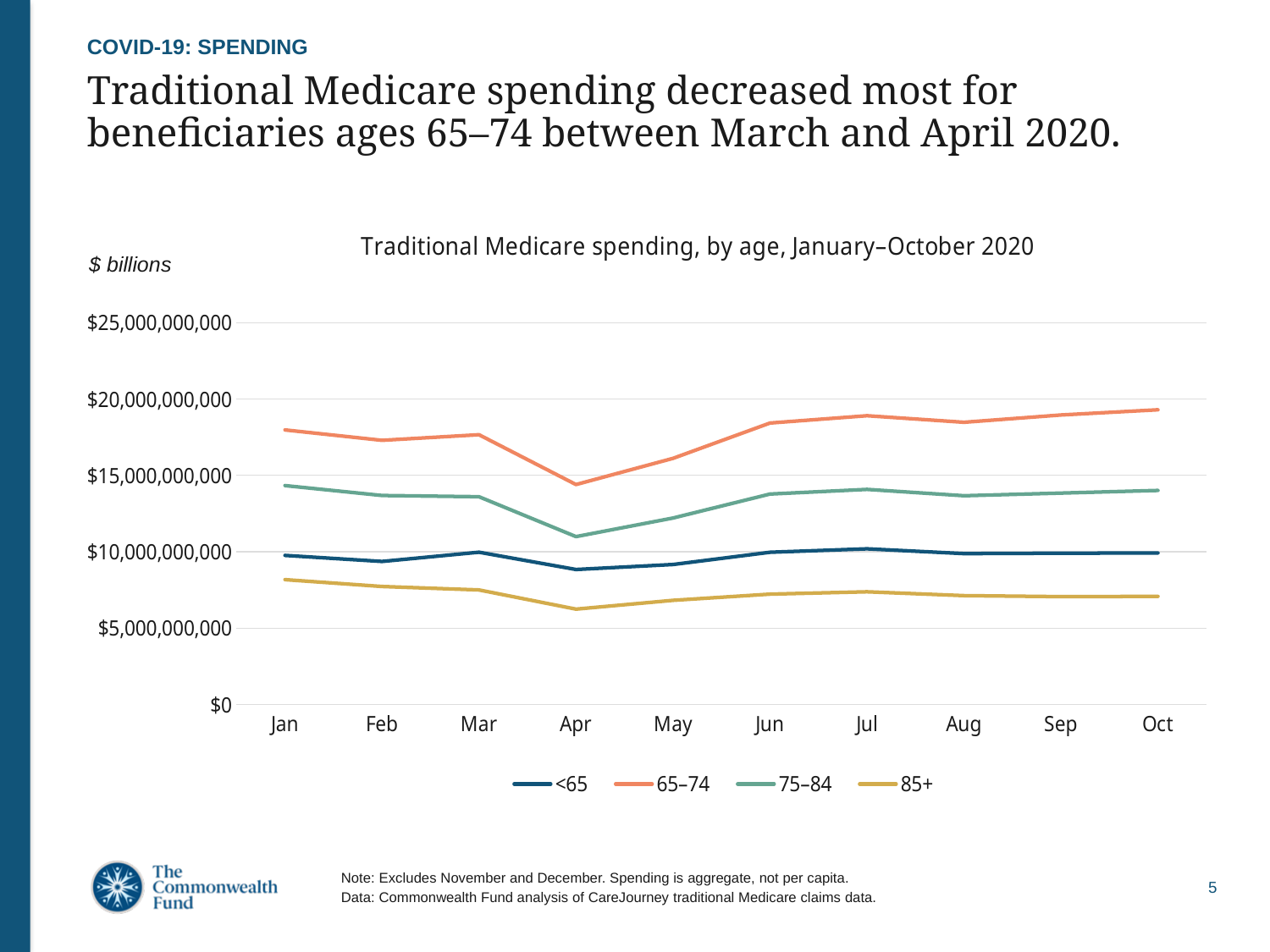
How many months are plotted along the x axis? 10 In which month is spending for the 65–74 group lowest? Apr Does spending for the 65–74 group rise or fall from March to April? fall What kind of chart is shown on the slide? line chart In January, which is larger: spending for the 65–74 group or the 75–84 group? 65–74 Which age group has the lowest spending across the chart? 85+ Is the value for the 65–74 group in April greater or less than $15,000,000,000? less Is the value for the 65–74 group in October greater or less than $20,000,000,000? less Which age group has the highest spending across the chart? 65–74 What is the title of the chart? Traditional Medicare spending, by age, January–October 2020 Is the value for the 75–84 group in April greater or less than $10,000,000,000? greater How many series does the legend list? 4